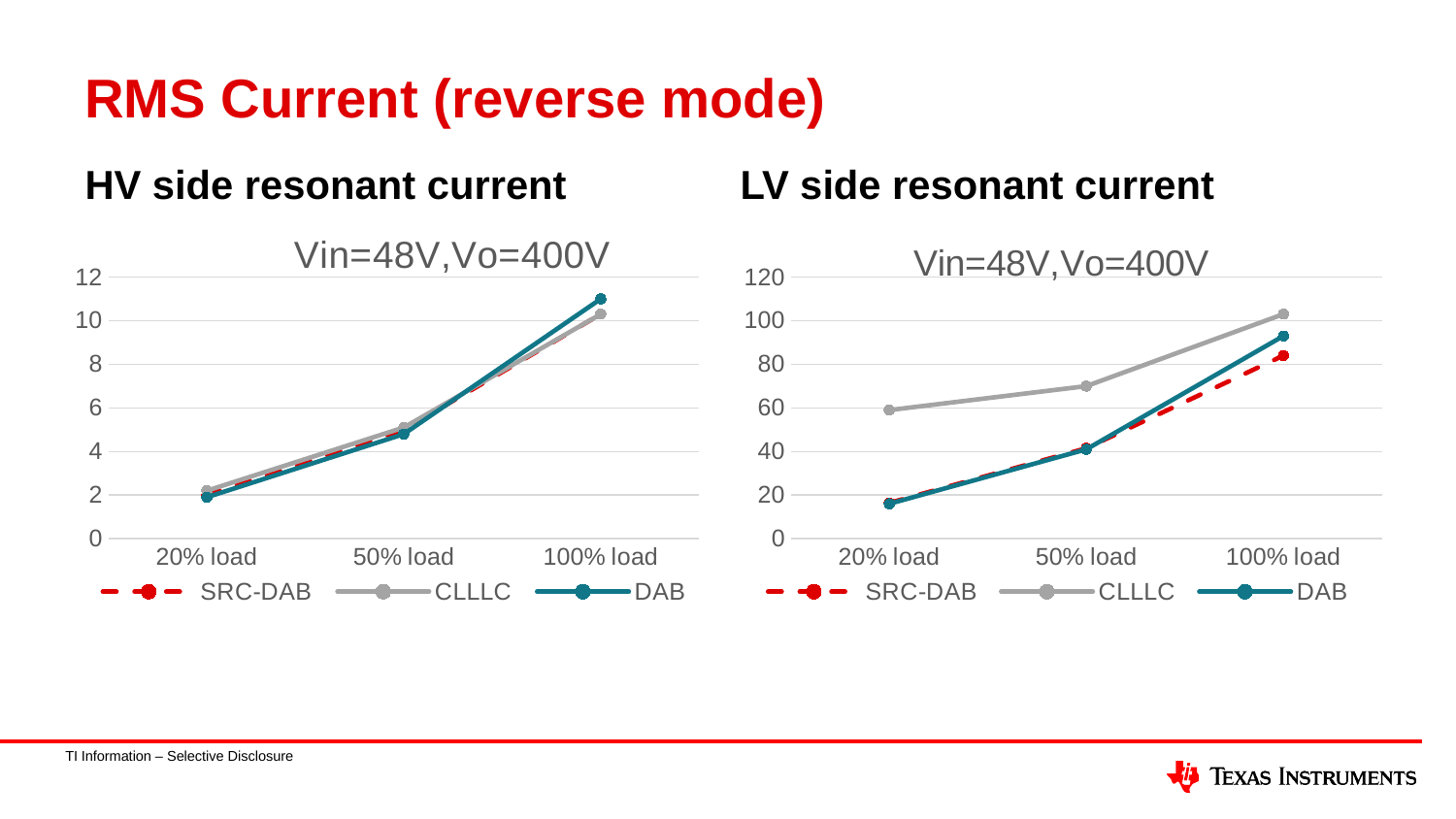
In the LV side resonant current chart, is the CLLLC value at 20% load greater or less than 80? less In the HV side resonant current chart, is the DAB value at 100% load greater or less than 10? greater How many load categories are shown on the x axis of the HV side resonant current chart? 3 In the LV side resonant current chart, does the CLLLC series rise or fall along the x axis? rise In the LV side resonant current chart, which is larger at 100% load, CLLLC or SRC-DAB? CLLLC In the HV side resonant current chart, is the DAB value at 20% load greater or less than 4? less How many series does the legend of the LV side resonant current chart list? 3 In the HV side resonant current chart, does the DAB series rise or fall from 20% load to 100% load? rise In the LV side resonant current chart, which series has the highest value at 20% load? CLLLC What is the title shown above the LV side resonant current chart's plot area? Vin=48V,Vo=400V What type of chart is the HV side resonant current chart on the left? line chart